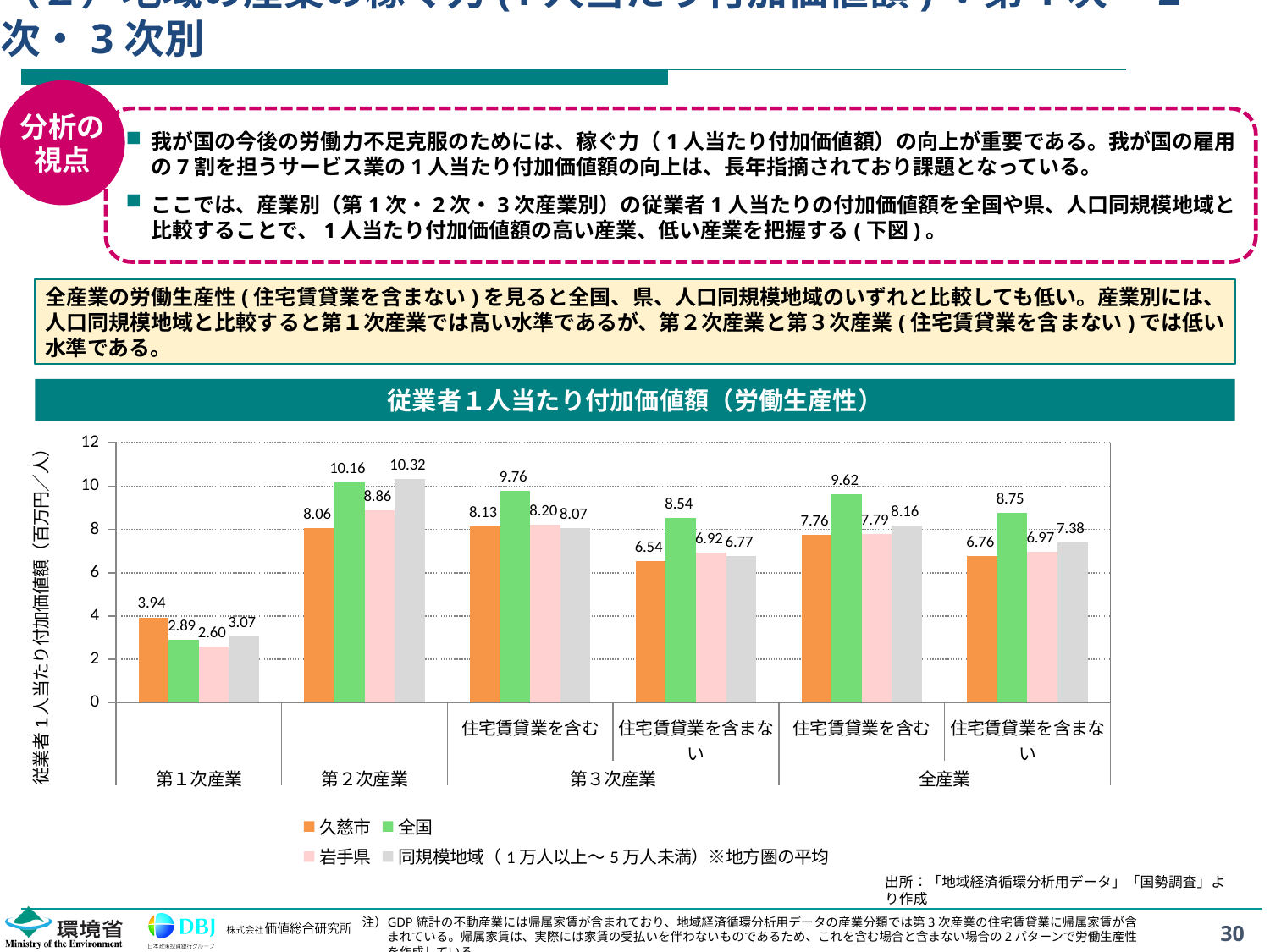
What type of chart is shown under the title 従業者１人当たり付加価値額（労働生産性）? bar chart What is the value for 久慈市 in 第１次産業? 3.94 What is the y-axis label of the chart? 従業者１人当たり付加価値額（百万円／人） What is the value for 全国 in 第２次産業? 10.16 Which series has the lowest value in 第１次産業? 岩手県 Which is larger in 第３次産業 (住宅賃貸業を含む): 久慈市 or 全国? 全国 What is the value for 同規模地域 in 全産業 (住宅賃貸業を含む)? 8.16 Is the value for 久慈市 in 第２次産業 greater or less than 10? less How many series does the legend of the chart list? 4 Which series has the highest value in 第２次産業? 同規模地域 What is the difference between 全国 and 久慈市 in 全産業 (住宅賃貸業を含まない)? 1.99 What is the value for 岩手県 in 第３次産業 (住宅賃貸業を含まない)? 6.92